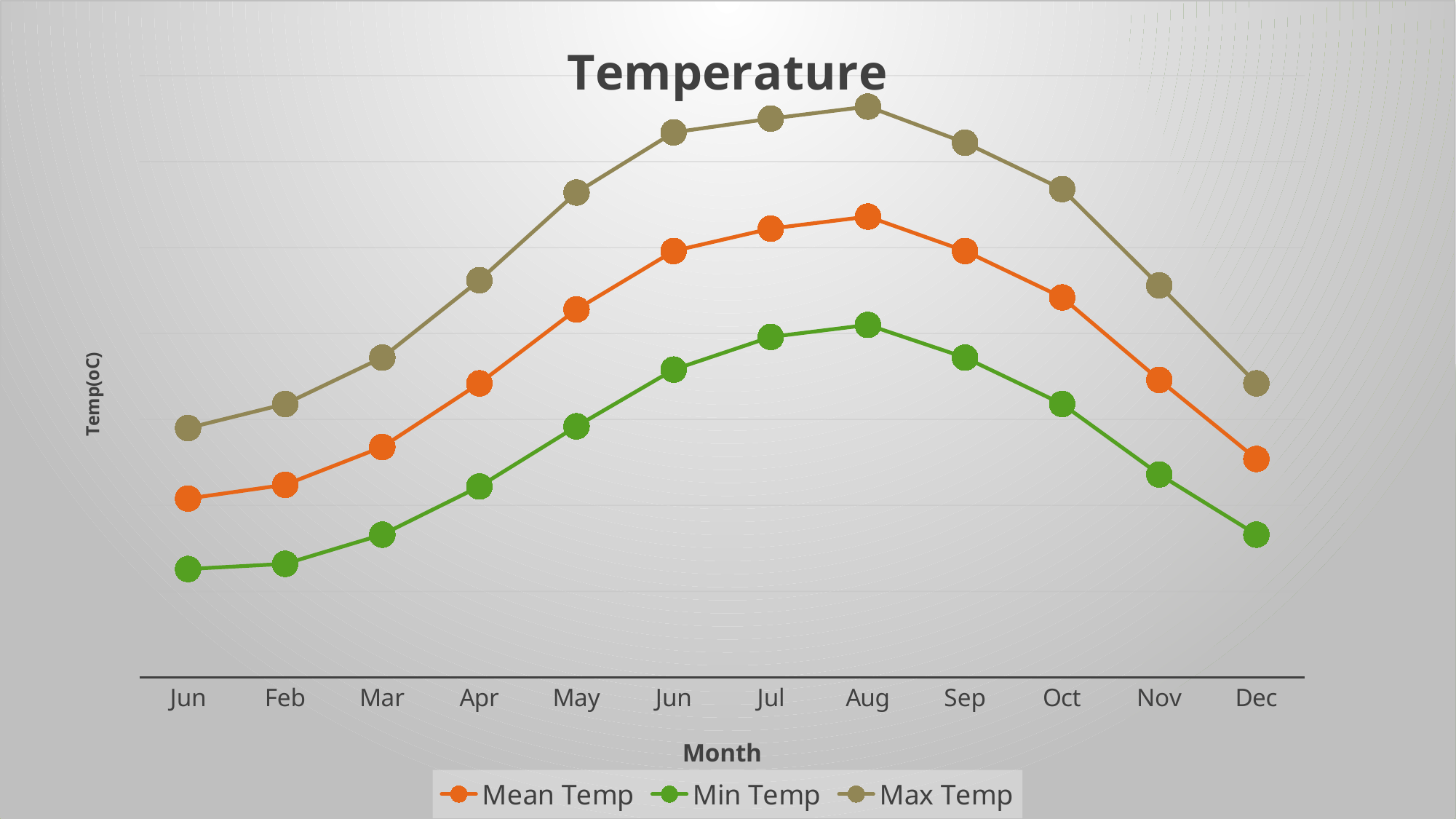
What kind of chart is shown on the slide? line chart What is the title of the chart? Temperature Which month has the highest Min Temp? Aug Does the Min Temp rise or fall from Aug to Dec? fall Is the Mean Temp higher in Jul or in Sep? Jul Which month has the highest Max Temp? Aug Is the Max Temp higher in Mar or in Nov? Nov Which series has the highest values in every month? Max Temp How many series does the legend list? 3 Which month has the highest Mean Temp? Aug Does the Mean Temp rise or fall from Feb to Jul? rise How many months are plotted along the x axis? 12